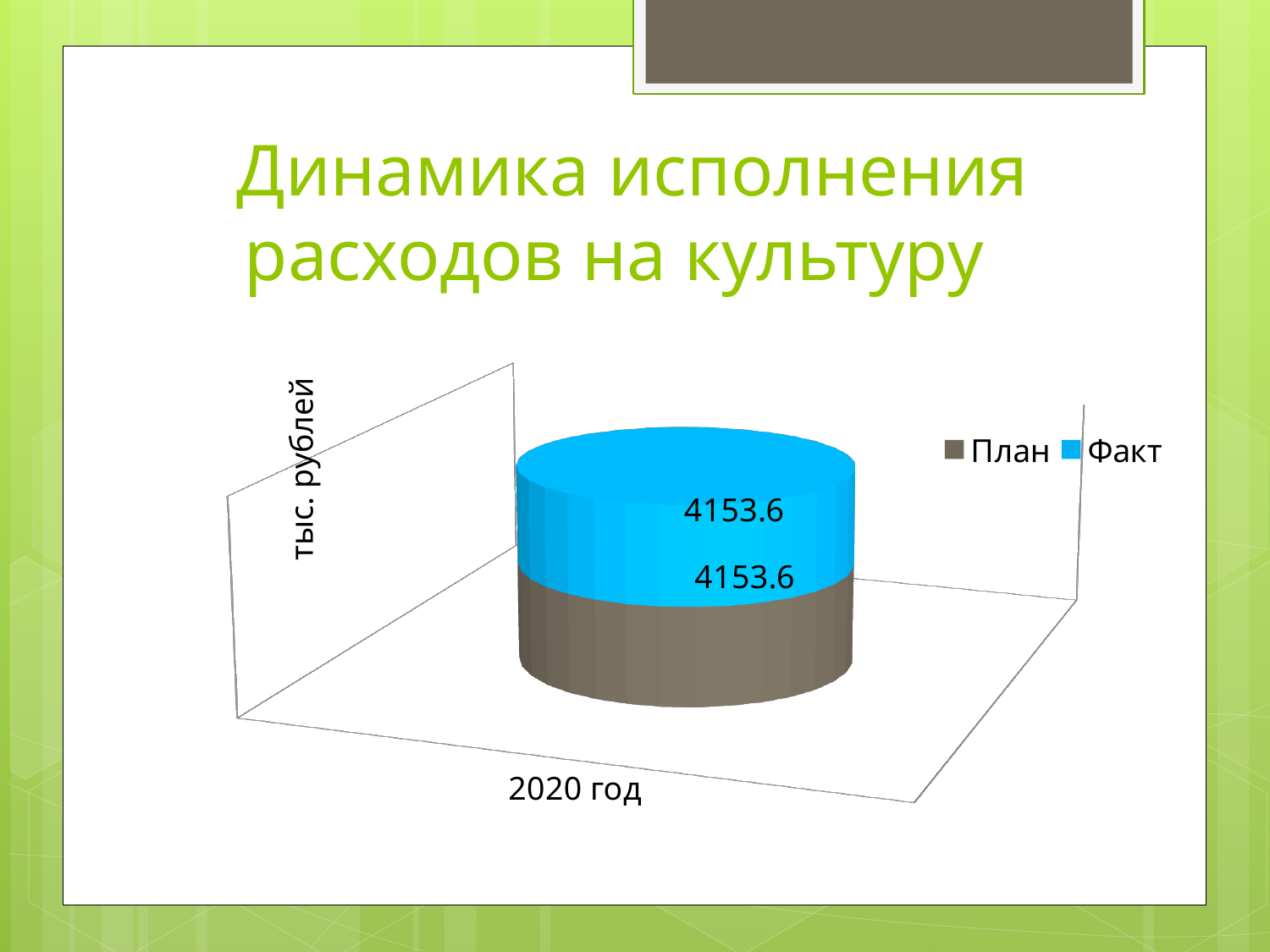
How many categories are shown on the x axis of the chart? 1 What is the difference between the Факт and План values for 2020 год? 0 What is the total of the stacked bar for 2020 год (План plus Факт)? 8307.2 What unit is shown on the vertical axis label of the chart? тыс. рублей What kind of chart is shown on the slide? Bar chart (stacked, 3D) What is the title of the chart on the slide? Динамика исполнения расходов на культуру Which category label appears on the x axis of the chart? 2020 год How many series does the legend list? 2 What is the value for План (plan) in 2020 год? 4153.6 What is the value for Факт (actual) in 2020 год? 4153.6 Is the Факт value for 2020 год larger than, smaller than, or equal to the План value? equal